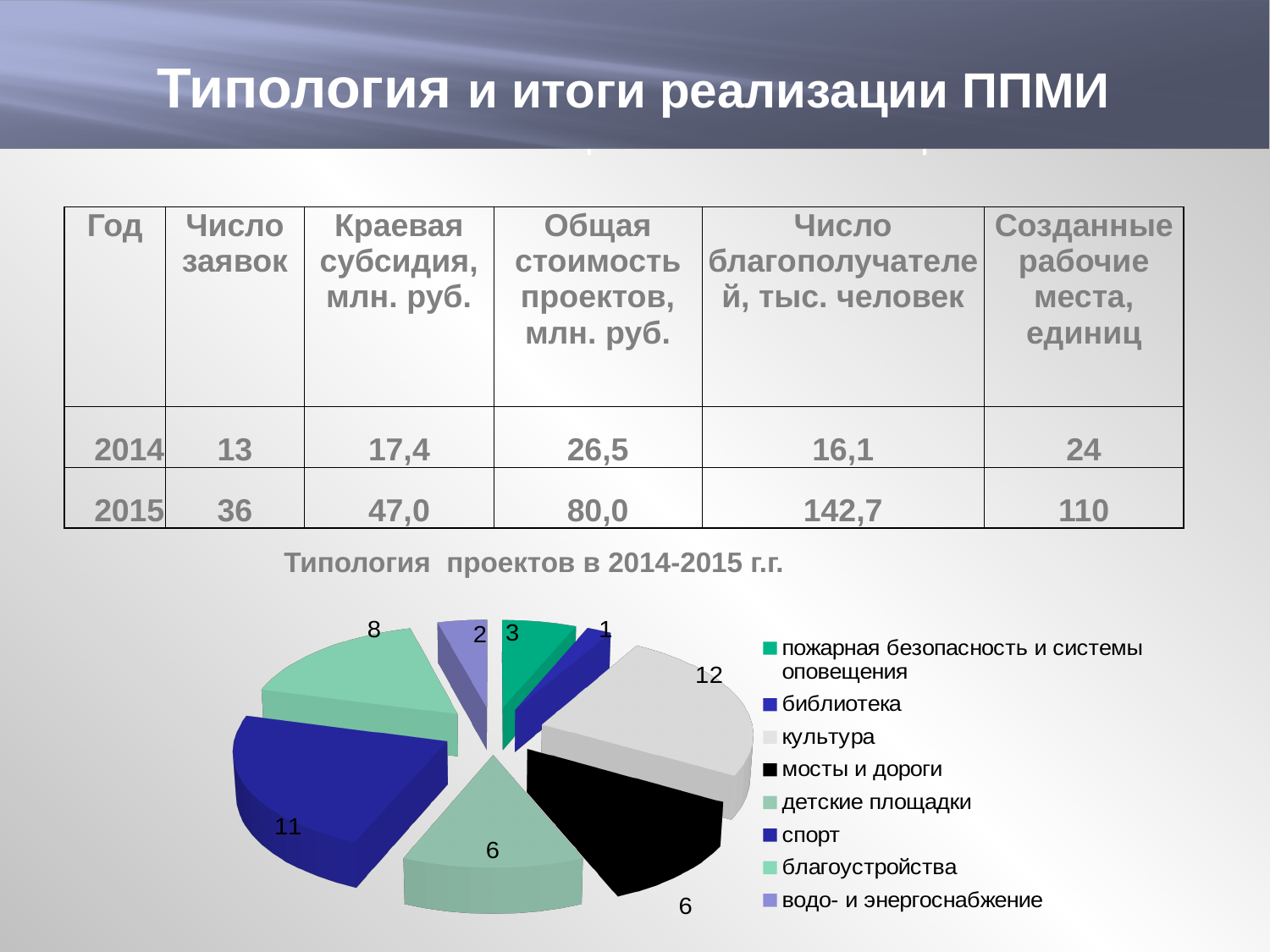
What is the title of the pie chart? Типология проектов в 2014-2015 г.г. Which category has the largest slice in the pie chart? культура Which category has the smallest slice in the pie chart? библиотека In the pie chart, which is larger: "благоустройства" or "пожарная безопасность и системы оповещения"? благоустройства What kind of chart is shown under the heading "Типология проектов в 2014-2015 г.г."? pie chart How many slices does the pie chart have? 8 How many entries does the legend of the pie chart list? 8 In the pie chart, what is the difference between the values for "культура" and "спорт"? 1 What is the value of the "библиотека" slice in the pie chart? 1 What is the value of the "благоустройства" slice in the pie chart? 8 What is the value of the "спорт" slice in the pie chart? 11 What is the value of the "культура" slice in the pie chart? 12